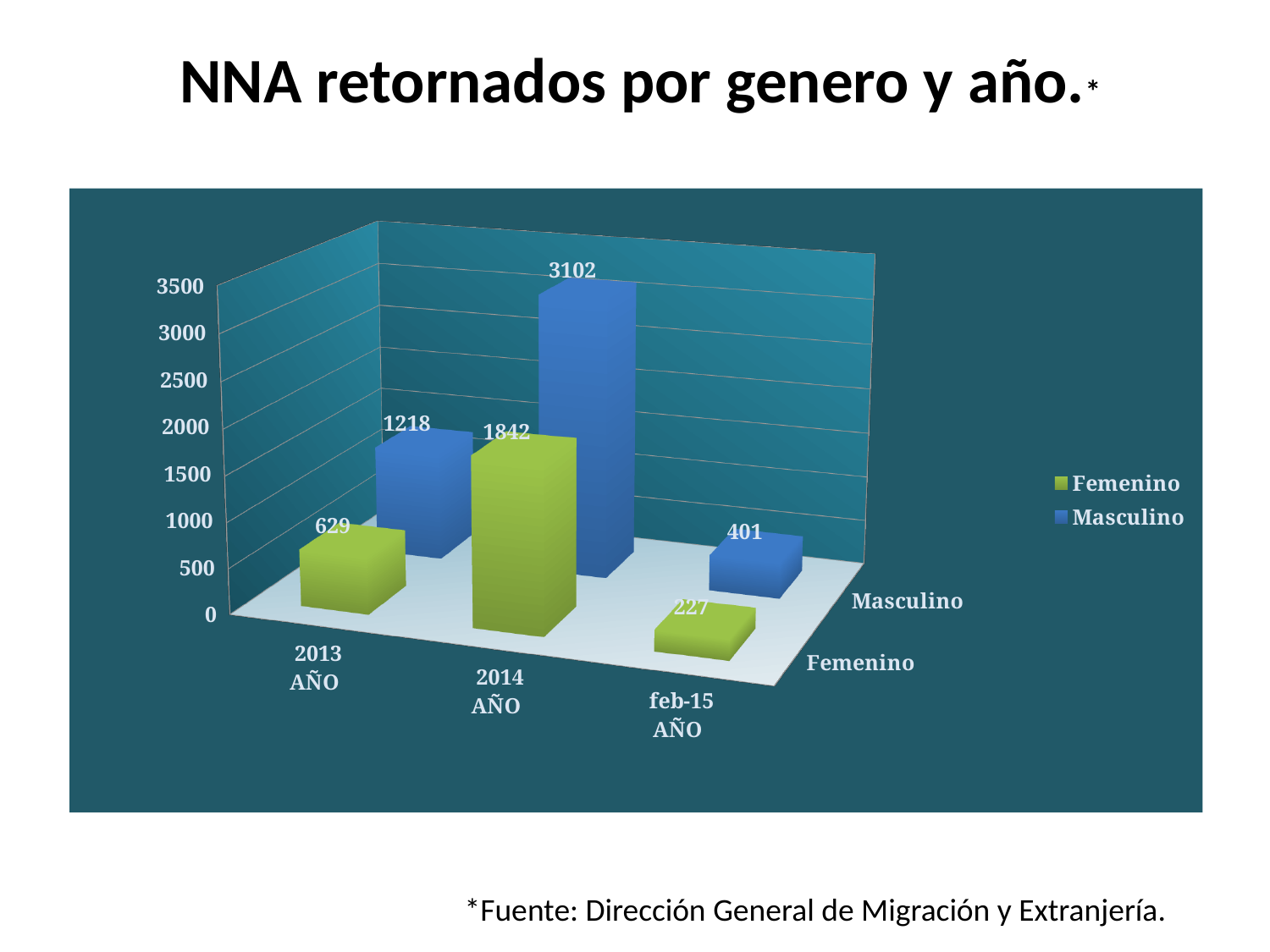
Which year has the lowest Femenino value? feb-15 AÑO How many series does the legend list? 2 What is the Masculino value for 2014 AÑO? 3102 Which is larger for feb-15 AÑO, the Femenino value or the Masculino value? Masculino What is the Masculino value for 2013 AÑO? 1218 What is the Femenino value for feb-15 AÑO? 227 What is the Femenino value for 2013 AÑO? 629 What kind of chart is shown on the slide? Bar chart Which year has the highest Masculino value? 2014 AÑO How many year categories are shown on the chart? 3 What is the title of the chart on the slide? NNA retornados por genero y año. What is the difference between the Masculino and Femenino values for 2014 AÑO? 1260